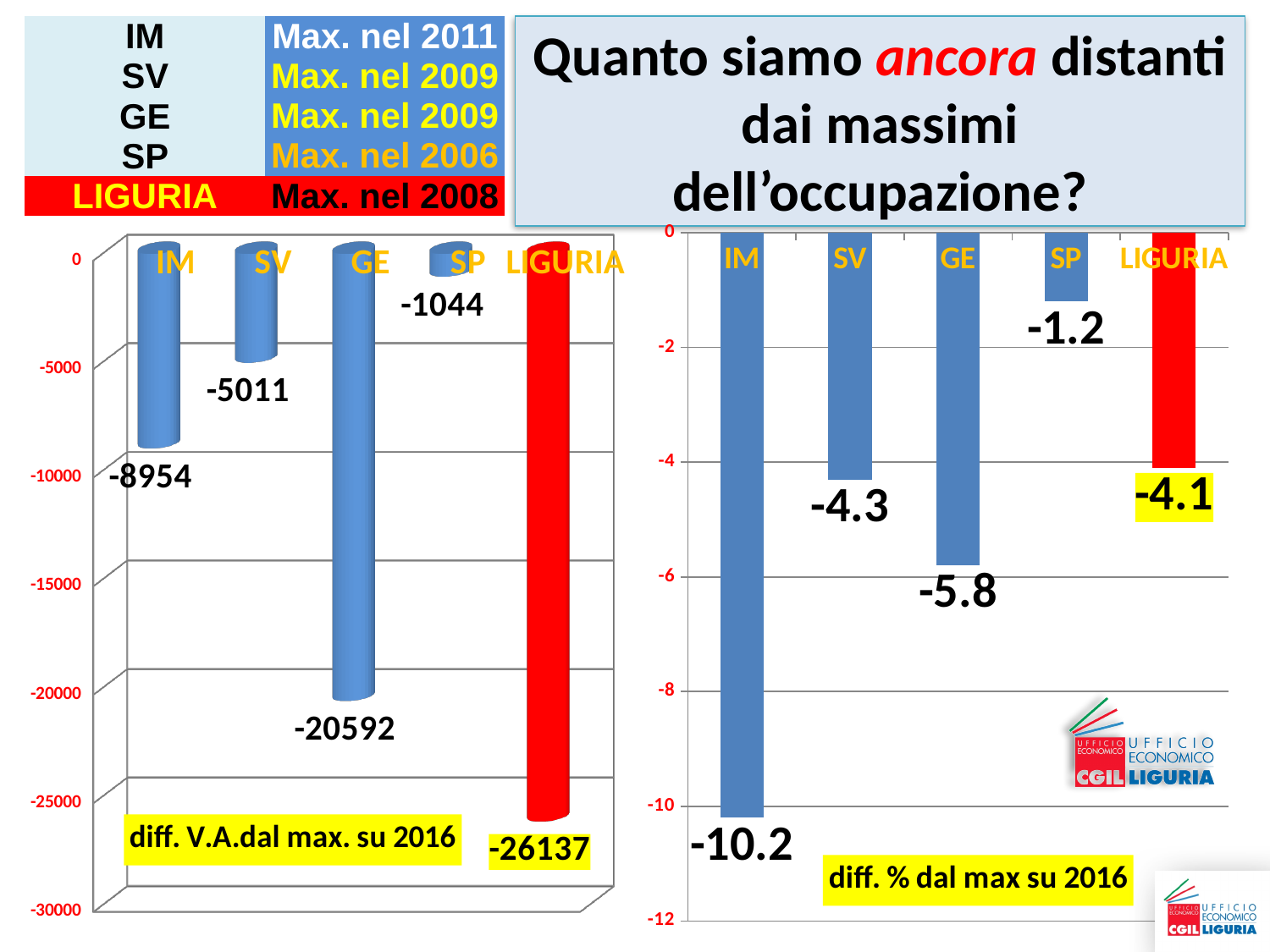
In the left chart (diff. V.A. dal max su 2016), what is the difference between the values for IM and SV? 3943 In the left chart (diff. V.A. dal max su 2016), what is the value for GE? -20592 In the left chart (diff. V.A. dal max su 2016), which category has the smallest absolute difference (the shortest bar)? SP In the right chart (diff. % dal max su 2016), what is the value for SP? -1.2 In the right chart (diff. % dal max su 2016), which category has the largest percentage drop (the longest bar)? IM In the right chart (diff. % dal max su 2016), what is the difference between the values for GE and SV? 1.5 In the right chart (diff. % dal max su 2016), what is the value for IM? -10.2 What type of chart is the right chart (diff. % dal max su 2016)? Bar chart How many categories are shown in the left chart (diff. V.A. dal max su 2016)? 5 In the left chart (diff. V.A. dal max su 2016), which bar is shown in red? LIGURIA In the left chart (diff. V.A. dal max su 2016), what is the value for LIGURIA? -26137 In the right chart (diff. % dal max su 2016), which bar is longer, SV or LIGURIA? SV